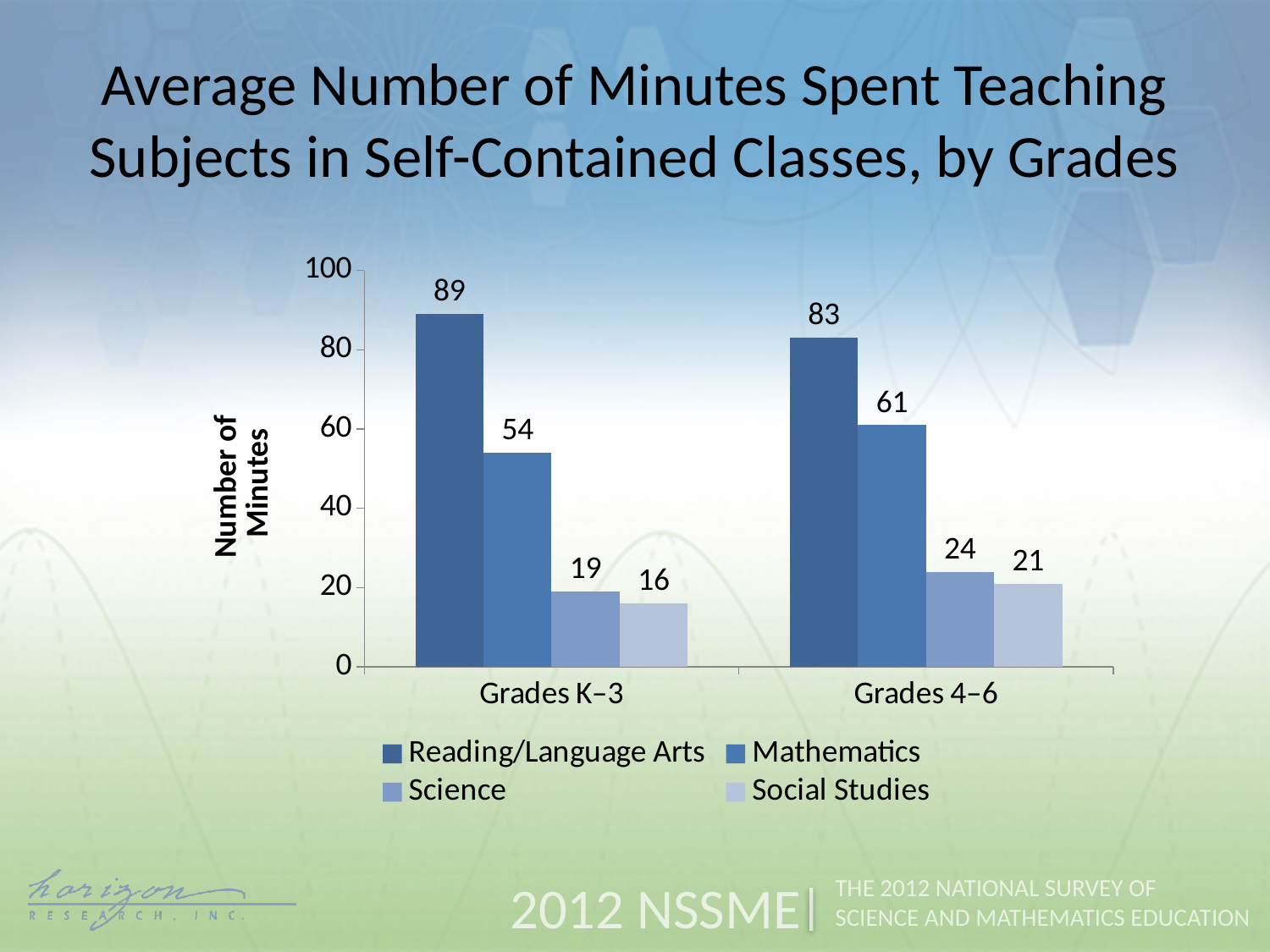
What kind of chart is shown on the slide? Bar chart How many series does the legend list? 4 What is the average number of minutes spent teaching Reading/Language Arts in Grades K–3? 89 Which subject has the highest average number of minutes in Grades 4–6? Reading/Language Arts How many grade groups are shown on the x axis? 2 What is the difference in minutes between Reading/Language Arts and Mathematics in Grades K–3? 35 What is the average number of minutes spent teaching Social Studies in Grades K–3? 16 What is the difference in minutes for Mathematics between Grades 4–6 and Grades K–3? 7 Which subject has the lowest average number of minutes in Grades K–3? Social Studies Which is larger: the minutes for Science in Grades K–3 or Science in Grades 4–6? Science in Grades 4–6 What is the average number of minutes spent teaching Mathematics in Grades 4–6? 61 What is the average number of minutes spent teaching Science in Grades 4–6? 24